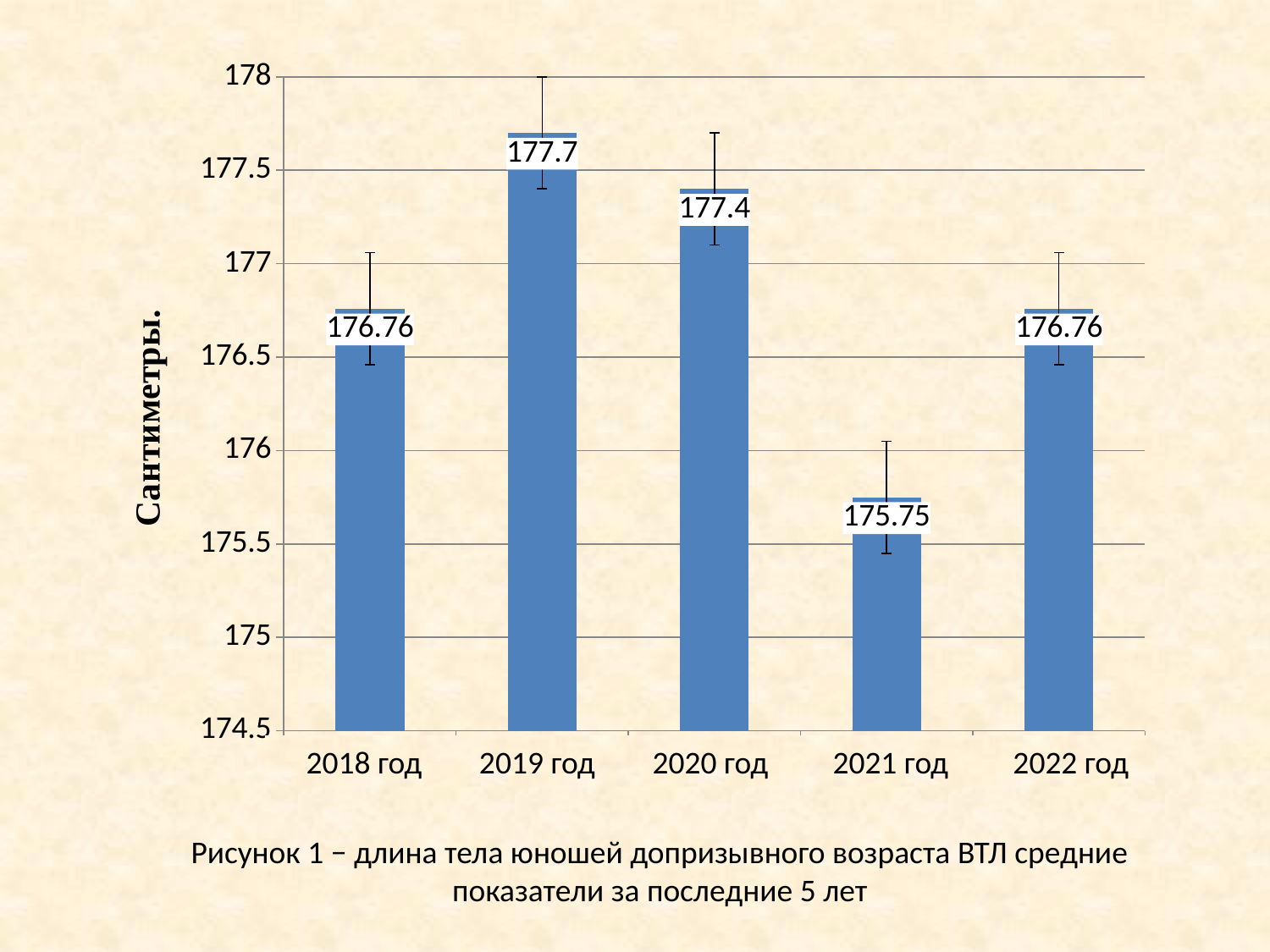
What is the value for 2018 год? 176.76 What is the difference between the values for 2019 год and 2021 год? 1.95 What is the value for 2020 год? 177.4 Which year has the highest value? 2019 год What is the difference between the values for 2019 год and 2020 год? 0.3 How many years are shown on the x axis? 5 What is the value for 2019 год? 177.7 Which is larger, the value for 2020 год or the value for 2022 год? 2020 год Which year has the lowest value? 2021 год Is the value for 2021 год greater or less than 176? less What is the value for 2021 год? 175.75 What kind of chart is this? bar chart